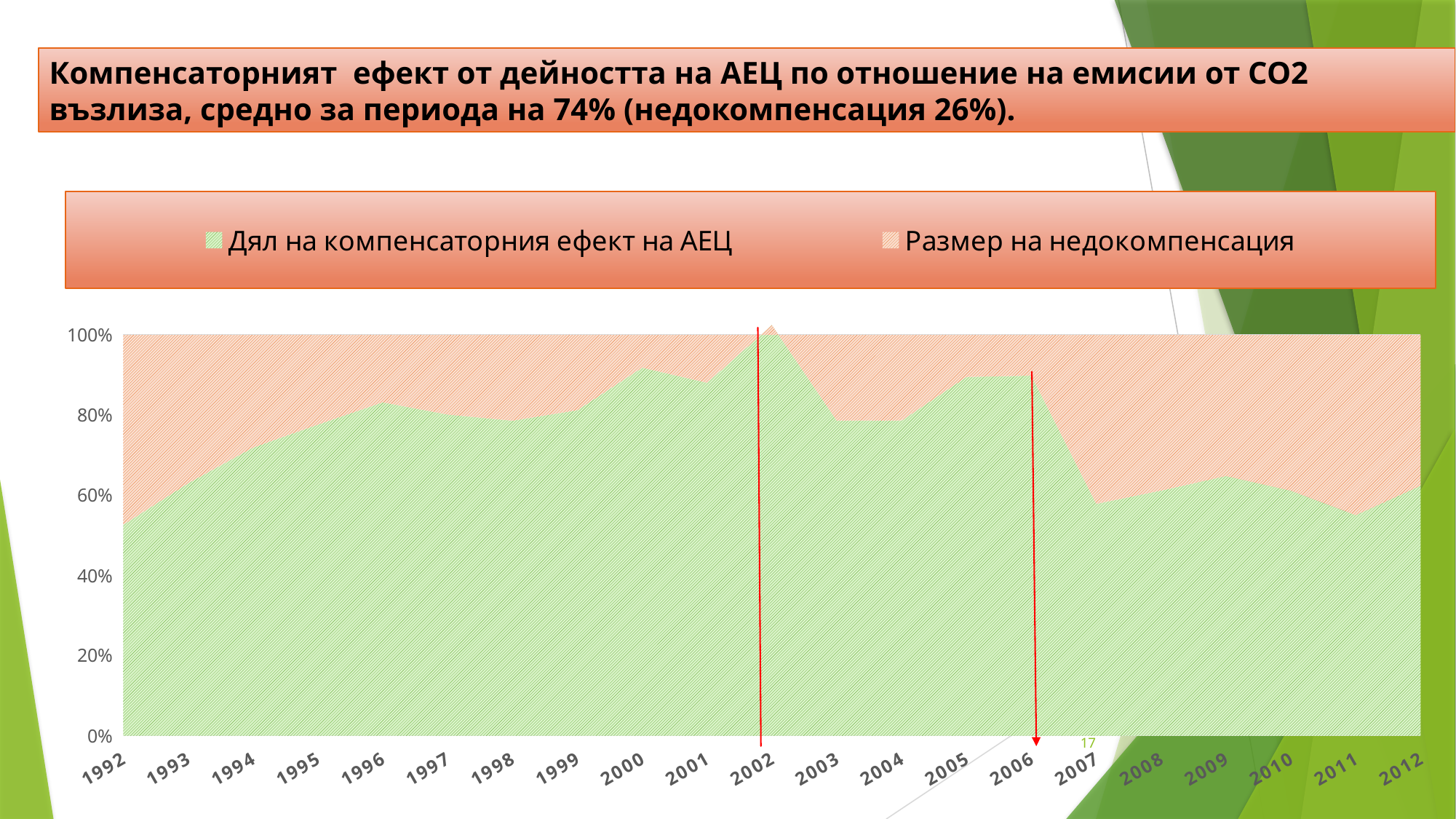
Does the share of the compensatory effect of the NPP rise or fall from 1992 to 1996? rise How many series does the legend list? 2 Is the share of the compensatory effect of the NPP in 1992 greater or less than 60%? less Which series is shown in green in the legend? Дял на компенсаторния ефект на АЕЦ In which year does the share of the compensatory effect of the NPP (Дял на компенсаторния ефект на АЕЦ) reach its highest value? 2002 Is the share of the compensatory effect of the NPP in 2000 greater or less than 80%? greater Which series is shown in orange in the legend? Размер на недокомпенсация Is the share of the compensatory effect of the NPP in 2007 greater or less than 80%? less Which year has a larger share of the compensatory effect of the NPP, 2006 or 2007? 2006 How many years are shown along the x axis? 21 What kind of chart is shown on the slide? Area chart